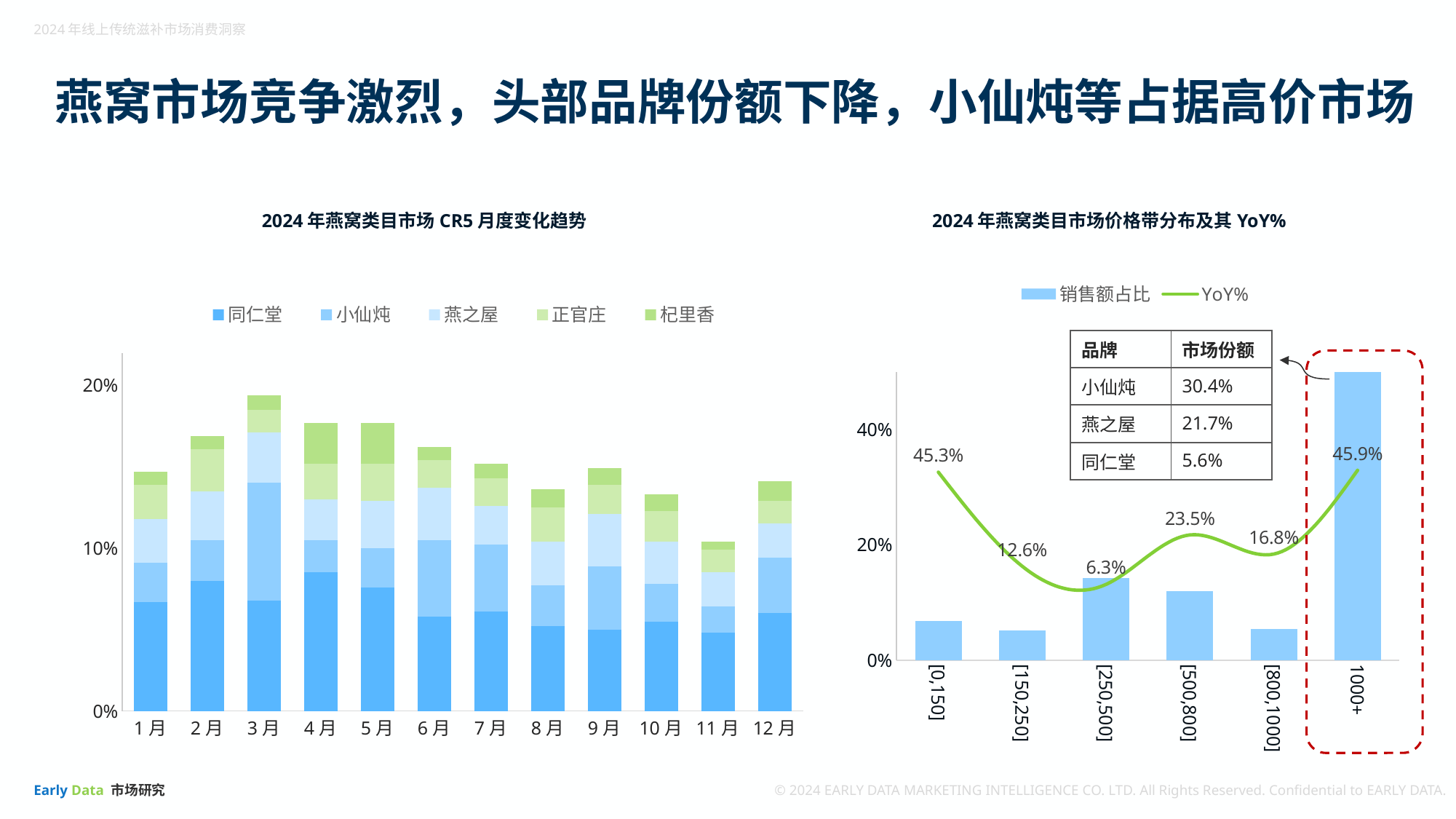
In the left chart (2024年燕窝类目市场CR5月度变化趋势), how many series does the legend list? 5 In the right chart (2024年燕窝类目市场价格带分布及其YoY%), what is the difference between the YoY% of [500,800] and [800,1000]? 6.7% In the right chart (2024年燕窝类目市场价格带分布及其YoY%), what is the YoY% for the 1000+ price band? 45.9% In the right chart (2024年燕窝类目市场价格带分布及其YoY%), what is the YoY% for the [0,150] price band? 45.3% In the table on the right chart, what is the 市场份额 listed for 小仙炖? 30.4% In the right chart (2024年燕窝类目市场价格带分布及其YoY%), which price band has the lowest YoY%? [250,500] In the left chart (2024年燕窝类目市场CR5月度变化趋势), is the total stacked value for 3月 greater or less than 15%? greater What kind of chart is the left chart, 2024年燕窝类目市场CR5月度变化趋势? Stacked bar chart In the left chart (2024年燕窝类目市场CR5月度变化趋势), which month has the highest total stacked bar? 3月 In the left chart (2024年燕窝类目市场CR5月度变化趋势), how many months are shown on the x axis? 12 In the right chart (2024年燕窝类目市场价格带分布及其YoY%), is the 销售额占比 bar for the 1000+ price band greater or less than 40%? greater In the left chart (2024年燕窝类目市场CR5月度变化趋势), which month has the lowest total stacked bar? 11月